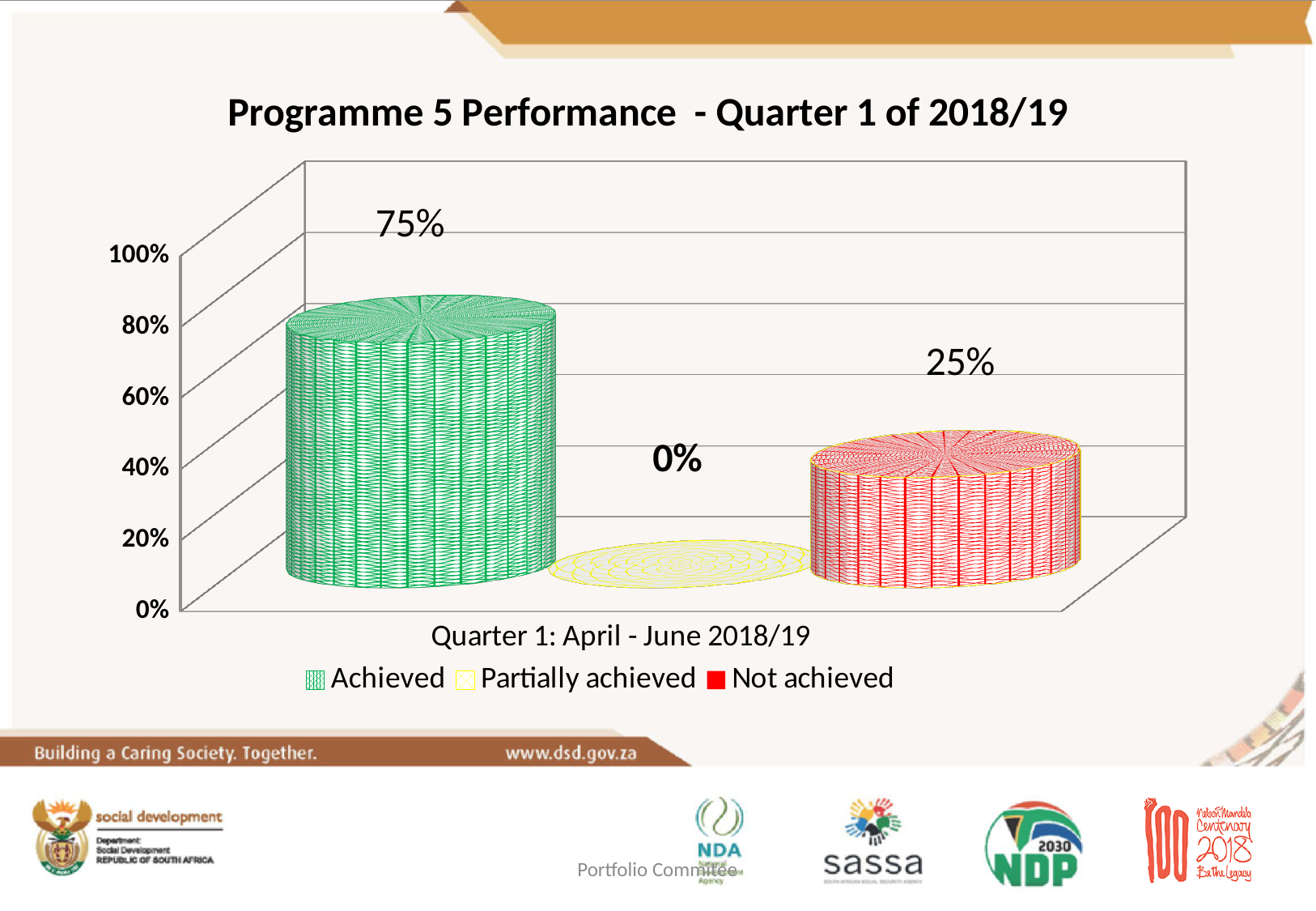
What is the difference between the Achieved and Not achieved values? 50% How many series does the legend list? 3 What is the value for Achieved in Quarter 1: April - June 2018/19? 75% Which series has the highest value? Achieved What kind of chart is shown on the slide? Bar chart What is the title of the chart? Programme 5 Performance - Quarter 1 of 2018/19 What is the value for Partially achieved in Quarter 1: April - June 2018/19? 0% Is the value for Not achieved greater or less than 40%? less Which is larger, the value for Achieved or the value for Not achieved? Achieved What is the value for Not achieved in Quarter 1: April - June 2018/19? 25% Which series has the lowest value? Partially achieved Is the value for Achieved greater or less than 60%? greater